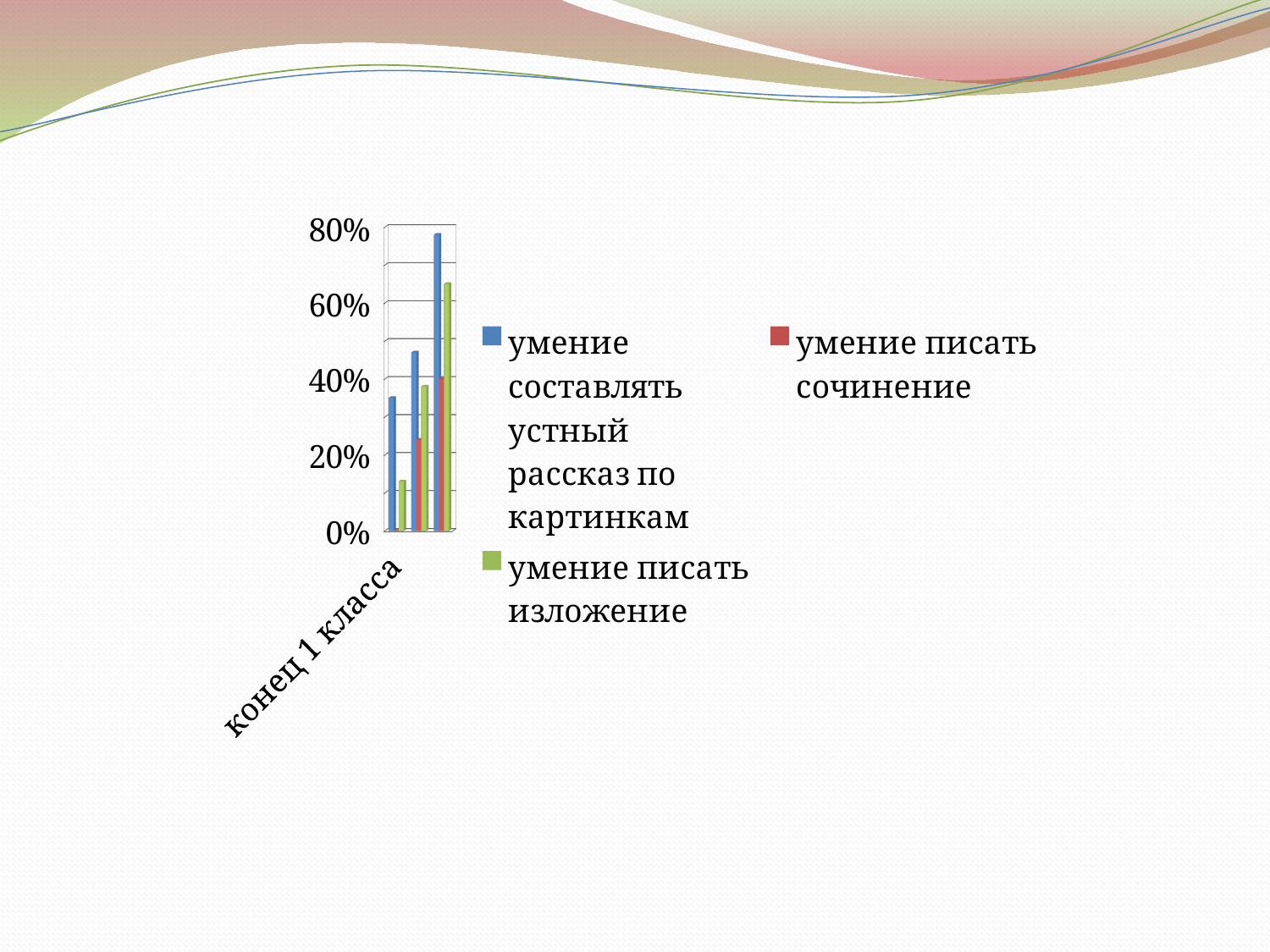
At конец 1 класса, which is larger: умение составлять устный рассказ по картинкам or умение писать изложение? умение составлять устный рассказ по картинкам Is the value for умение писать изложение at конец 1 класса greater or less than 20%? less How many groups of bars are plotted on the chart? 3 Which series has the highest value at конец 1 класса? умение составлять устный рассказ по картинкам Which series is shown in green in the legend? умение писать изложение How many series does the legend list? 3 What kind of chart is shown on the slide? bar chart Which series is shown in red in the legend? умение писать сочинение Is the value for умение составлять устный рассказ по картинкам at конец 1 класса greater or less than 40%? less Is the highest value for умение составлять устный рассказ по картинкам greater or less than 60%? greater Which series has the lowest value at конец 1 класса? умение писать сочинение Do the bars for умение составлять устный рассказ по картинкам rise or fall from left to right along the x axis? rise